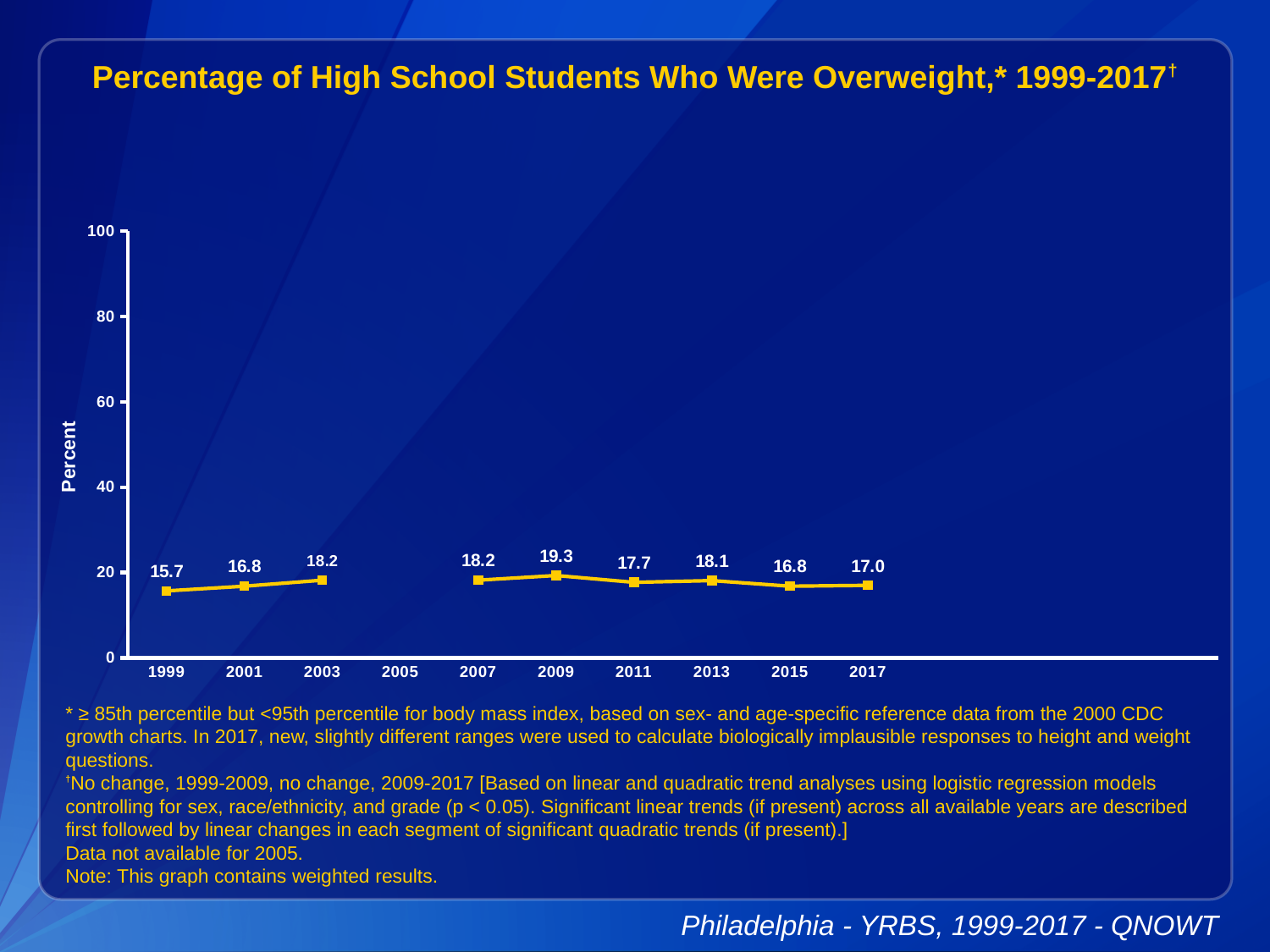
Which year on the x axis has no data point plotted? 2005 Is the value for 2009 greater or less than 20? less What was the percentage of high school students who were overweight in 2017? 17.0 Which year had the highest percentage of overweight high school students? 2009 What was the percentage of high school students who were overweight in 1999? 15.7 Did the percentage rise or fall from 2009 to 2011? fall Which year had the lowest percentage of overweight high school students? 1999 What kind of chart is shown on the slide? line chart What is the difference between the 2009 value and the 1999 value? 3.6 Which year had a higher percentage of overweight students, 2011 or 2013? 2013 What was the percentage of high school students who were overweight in 2009? 19.3 How many years have data points plotted on the chart? 9